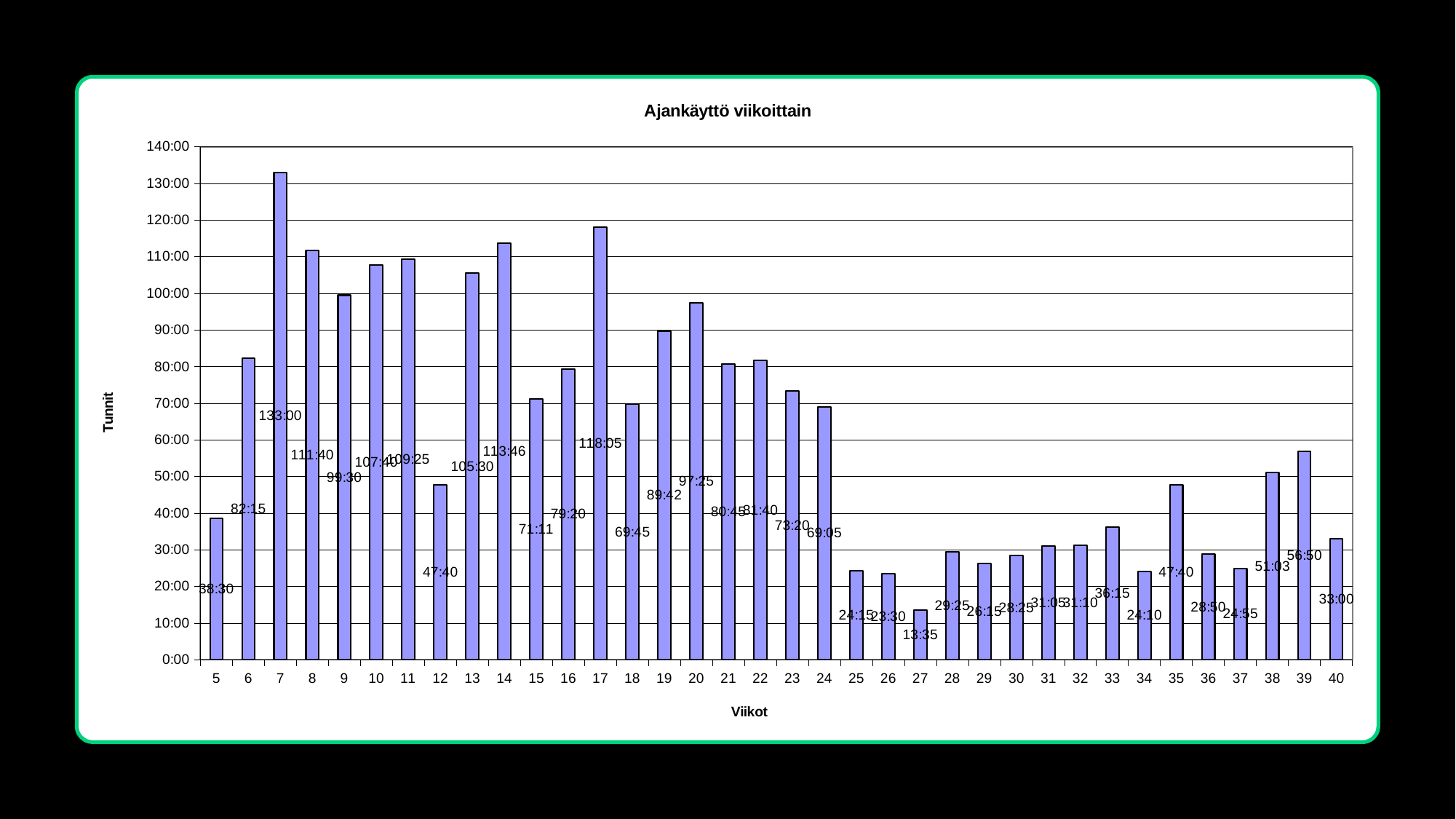
What is the value for week 27? 13:35 What kind of chart is shown on the slide? bar chart What is the value for week 7? 133:00 Is the value for week 14 greater or less than 110:00? greater What is the value for week 39? 56:50 Do the values rise or fall from week 20 to week 27? fall How many weeks are plotted on the x axis? 36 Which week has the highest value? 7 Which week has the lowest value? 27 What is the value for week 17? 118:05 What is the title of the chart? Ajankäyttö viikoittain Which is larger, the value for week 17 or the value for week 20? week 17